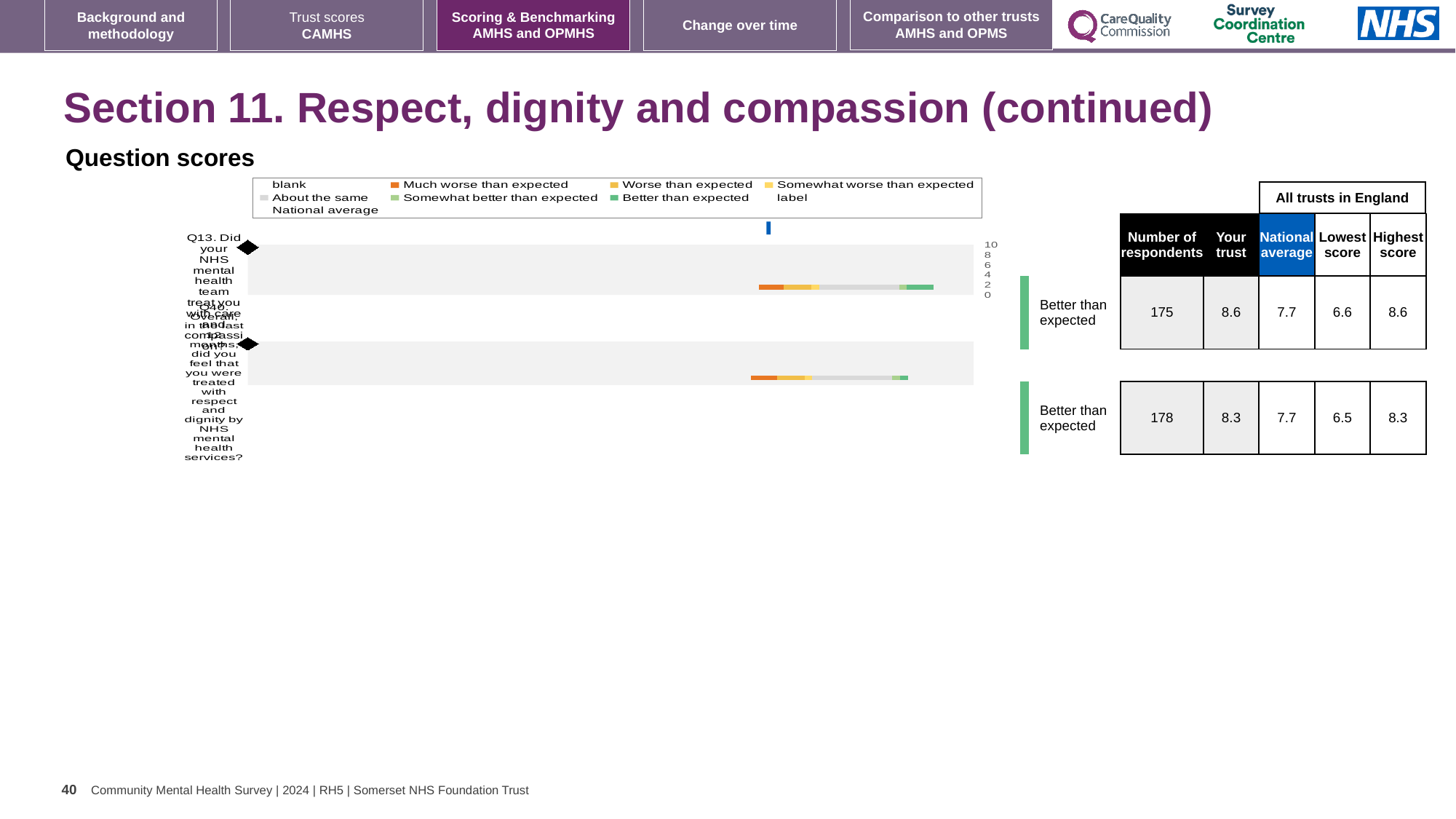
What is the 'Your trust' score for Q13 in the table beside the chart? 8.6 In the legend of the 'Question scores' chart, what colour represents 'Better than expected'? green What is the national average score for Q40? 7.7 What is the 'Your trust' score for Q40 in the table beside the chart? 8.3 How many questions are plotted in the 'Question scores' chart? 2 What kind of chart is shown under 'Question scores'? bar chart Which question has the higher 'Your trust' score, Q13 or Q40? Q13 What is the difference between the 'Your trust' score and the national average for Q13? 0.9 How many entries does the legend of the 'Question scores' chart list? 9 How many respondents are listed for Q40? 178 How many respondents are listed for Q13? 175 What is the lowest score across all trusts in England for Q40? 6.5